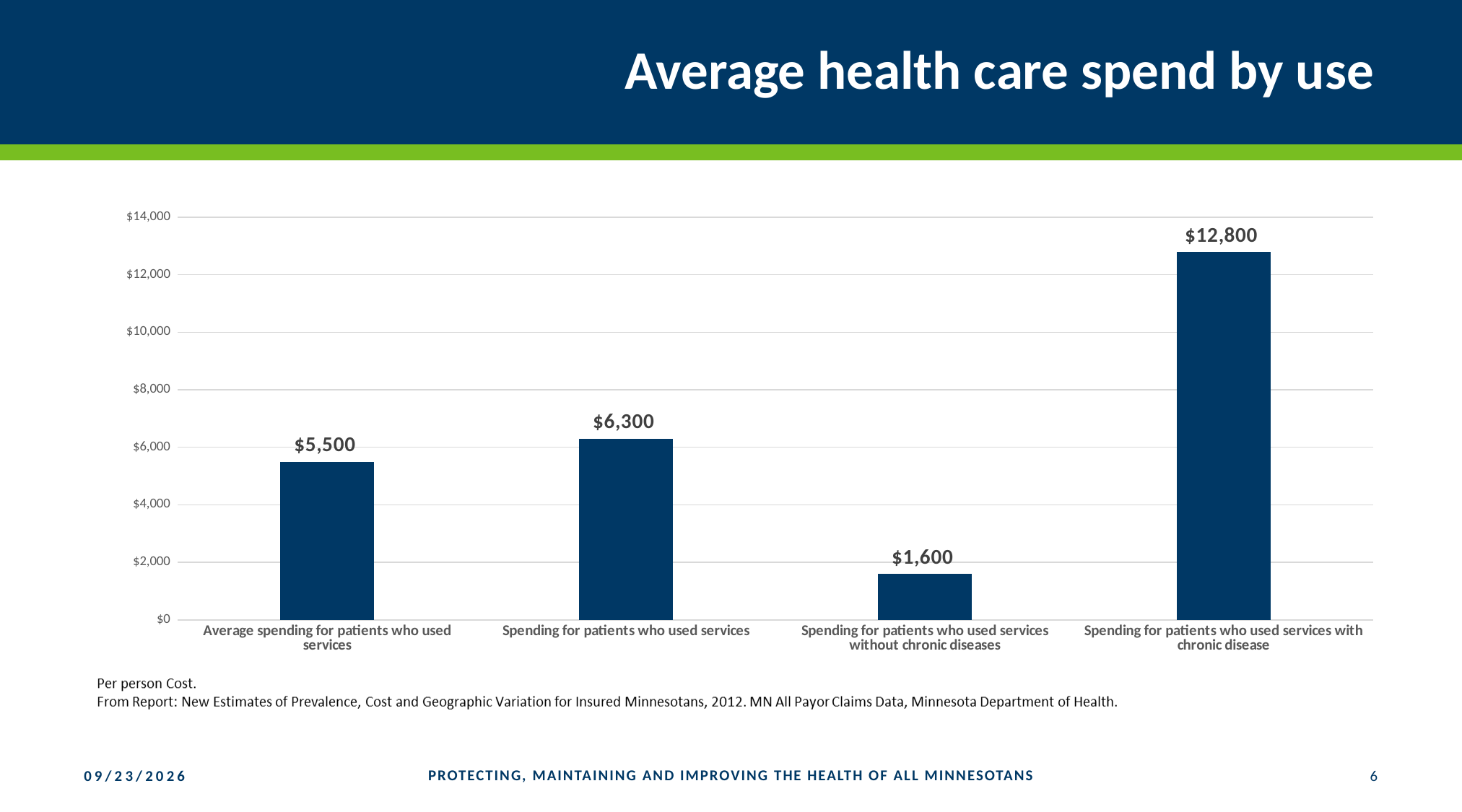
What is the value for 'Spending for patients who used services without chronic diseases'? $1,600 What is the value for 'Average spending for patients who used services'? $5,500 What is the value for 'Spending for patients who used services with chronic disease'? $12,800 What is the difference between spending for patients with chronic disease and spending for patients without chronic diseases? $11,200 Is the value for 'Spending for patients who used services with chronic disease' greater or less than $12,000? greater What kind of chart is shown on the slide? Bar chart Which is larger: 'Average spending for patients who used services' or 'Spending for patients who used services'? Spending for patients who used services Which category has the highest value? Spending for patients who used services with chronic disease What is the difference between 'Spending for patients who used services' and 'Average spending for patients who used services'? $800 How many categories are shown in the chart? 4 Which category has the lowest value? Spending for patients who used services without chronic diseases What is the value for 'Spending for patients who used services'? $6,300